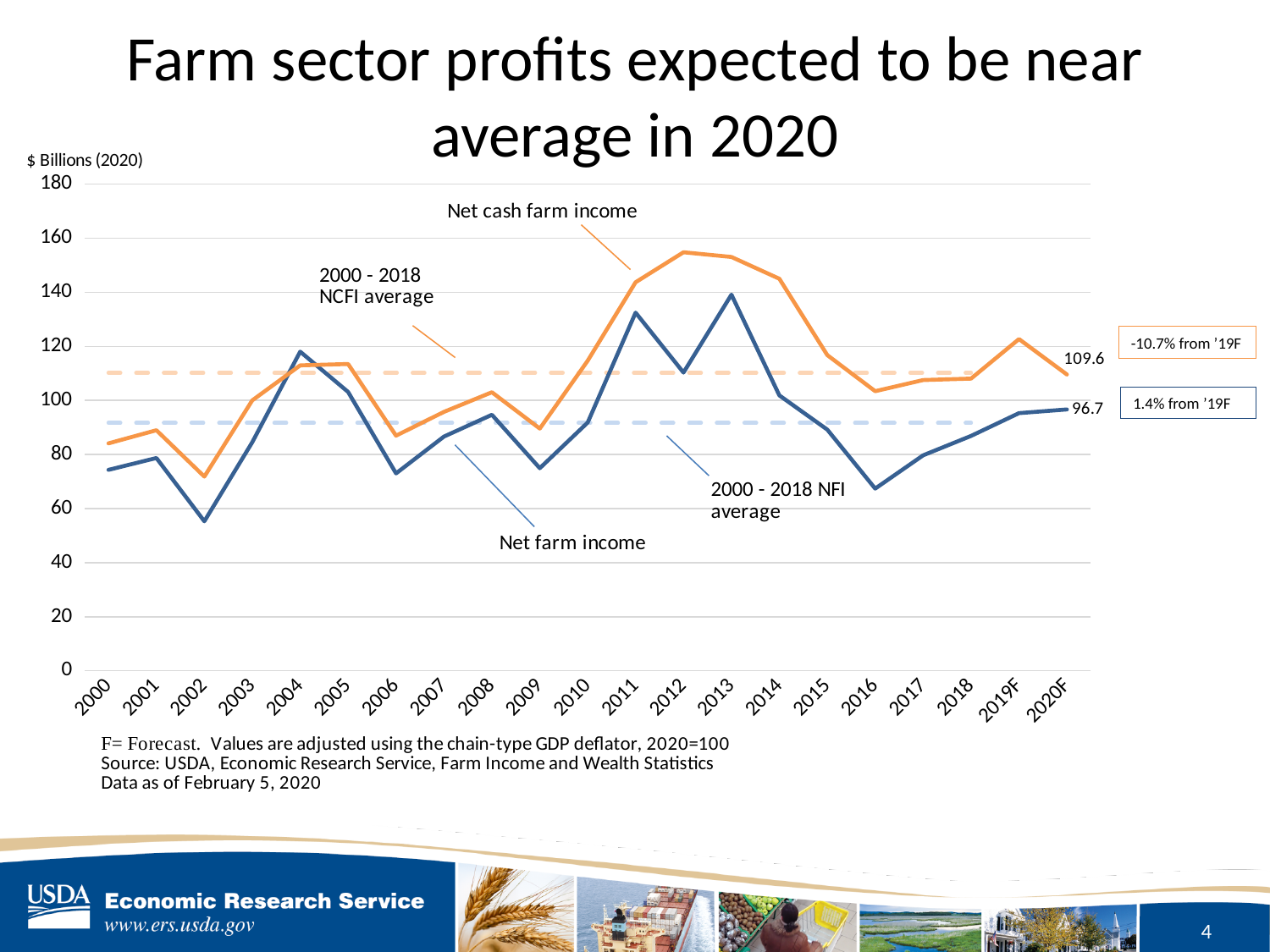
In 2020F, which is larger: net cash farm income or net farm income? Net cash farm income Is the value for net cash farm income in 2012 greater or less than 140? greater What is the difference between net cash farm income and net farm income in 2020F? 12.9 Does net farm income rise or fall from 2013 to 2016? fall In which year is net cash farm income at its lowest? 2002 How many years are shown on the x axis? 21 In which year is net farm income at its lowest? 2002 What is the value of net farm income for 2020F? 96.7 Is the value for net farm income in 2016 greater or less than 80? less What is the value of net cash farm income for 2020F? 109.6 In which year is net farm income at its highest? 2013 What kind of chart is shown on the slide? line chart